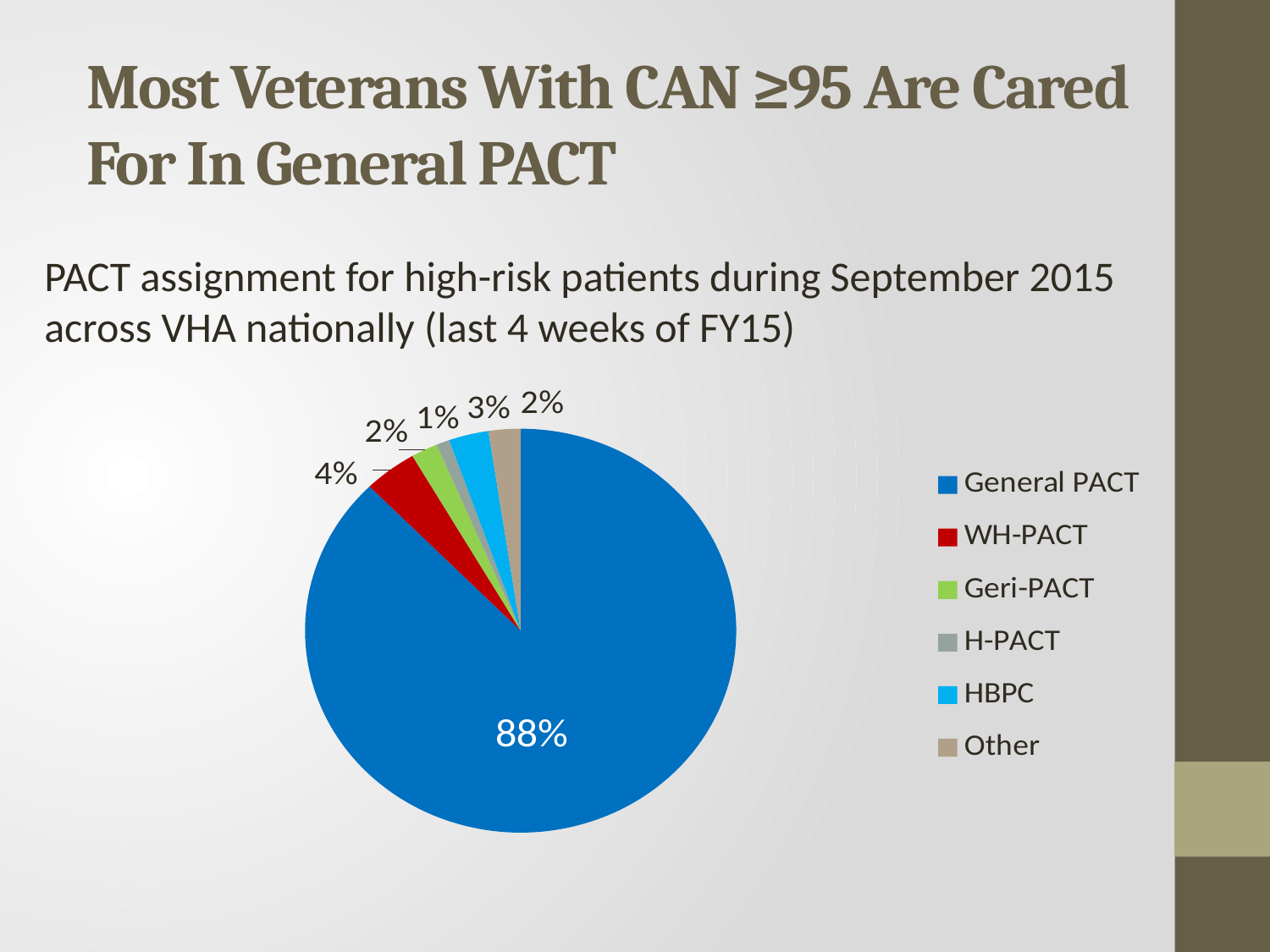
Which category has the smallest slice of the pie? H-PACT How many categories does the legend list? 6 What colour is the General PACT slice in the pie chart? blue What type of chart is shown on the slide? pie chart Which is larger, the share for WH-PACT or the share for HBPC? WH-PACT What percentage is shown for HBPC? 3% What share of the pie does General PACT account for? 88% What is the difference in percentage points between General PACT and WH-PACT? 84 What percentage is shown for WH-PACT? 4% What percentage is shown for H-PACT? 1% What percentage is shown for Geri-PACT? 2% Which category has the largest slice of the pie? General PACT